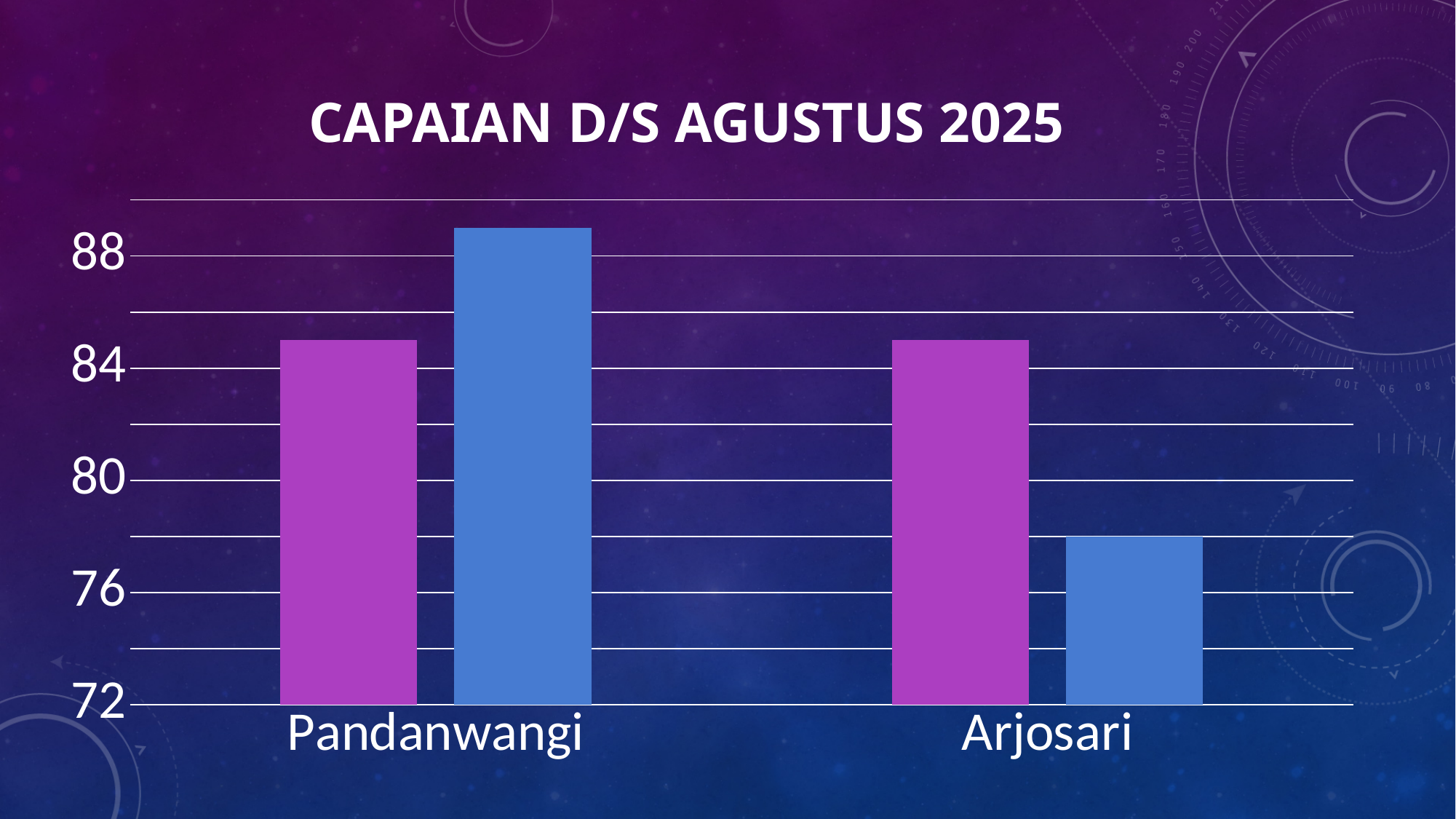
Is the value of the blue bar for Pandanwangi greater or less than 88? greater Is the value of the purple bar for Pandanwangi greater or less than 84? greater What is the title of the chart? CAPAIAN D/S AGUSTUS 2025 Which category has the shortest bar in the chart? Arjosari Is the value of the purple bar for Arjosari greater or less than 88? less Which is larger for Arjosari, the purple bar or the blue bar? the purple bar Which category has the tallest bar in the chart? Pandanwangi What is the lowest value shown on the vertical axis of the chart? 72 How many categories are shown on the x axis of the chart? 2 What kind of chart is shown on the slide? bar chart Which is larger, the blue bar for Pandanwangi or the blue bar for Arjosari? Pandanwangi